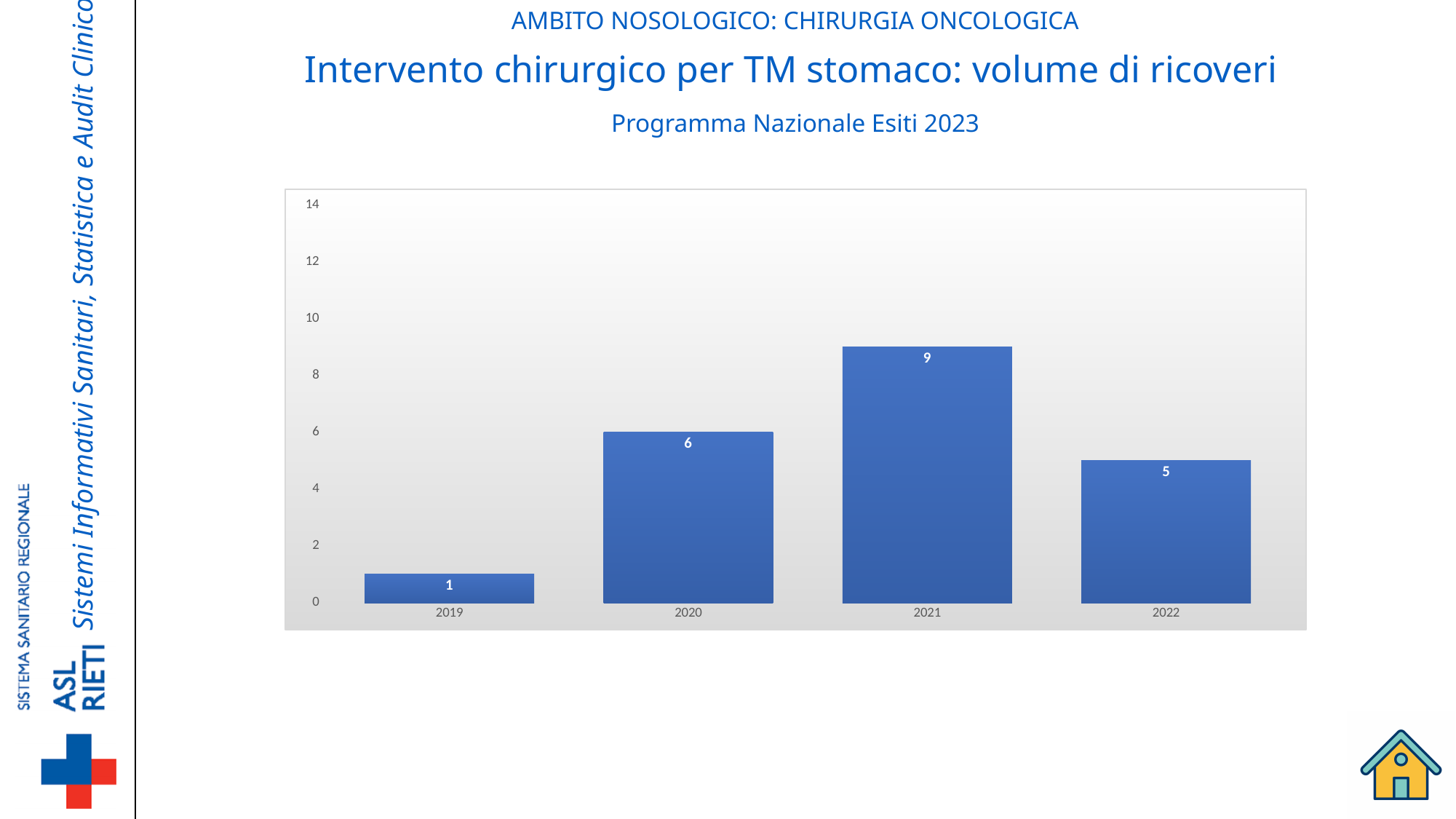
What kind of chart is shown on the slide? bar chart Which is larger, the value for 2020 or the value for 2022? 2020 Which year has the highest value? 2021 What is the value for 2020? 6 What is the difference between the values for 2021 and 2022? 4 What is the value for 2019? 1 Is the value for 2021 greater or less than 10? less Which year has the lowest value? 2019 What is the value for 2021? 9 What is the title of the slide's chart section? Intervento chirurgico per TM stomaco: volume di ricoveri What is the value for 2022? 5 How many years are shown on the x axis? 4